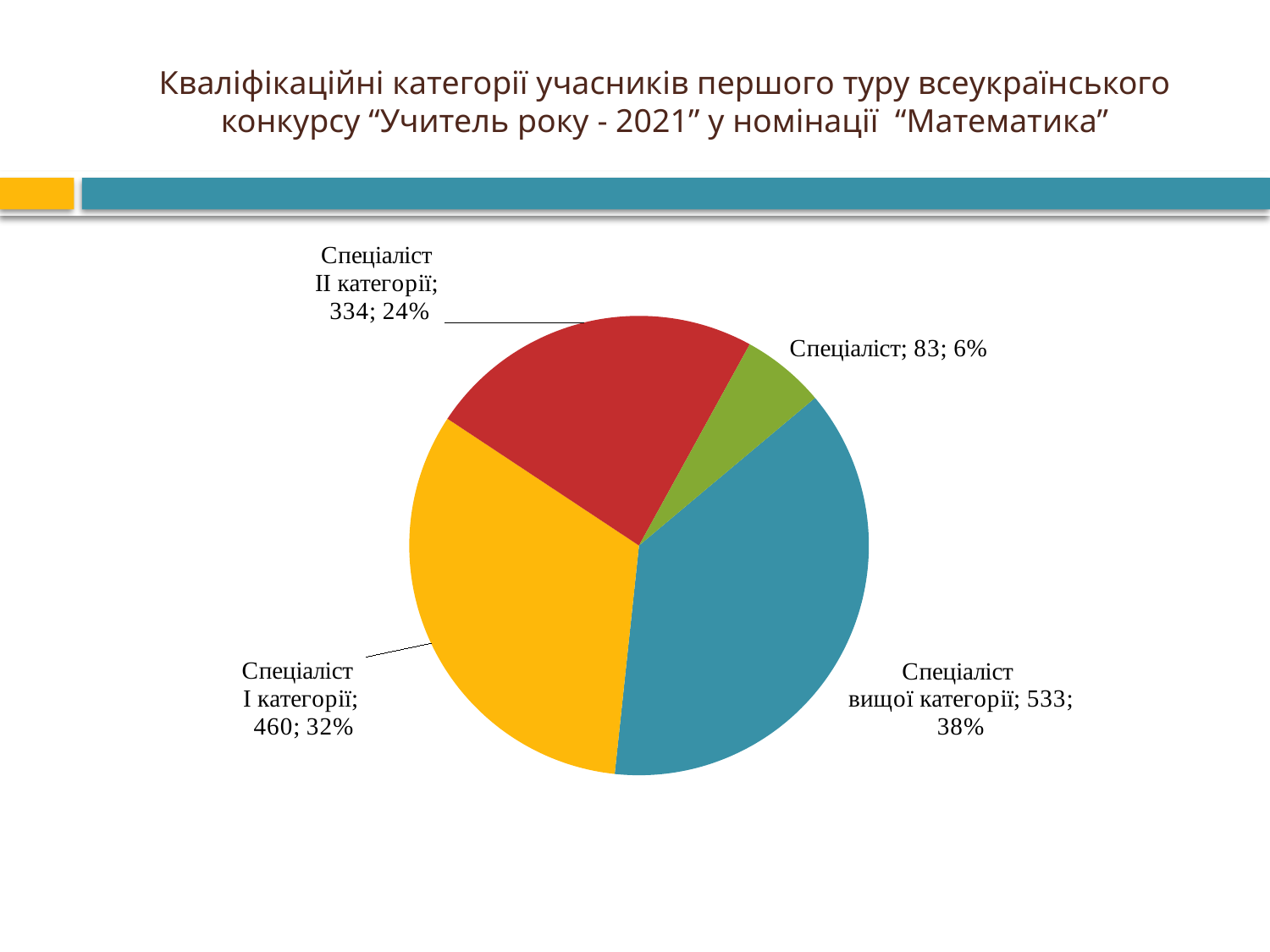
How many slices does the pie chart have? 4 Which category has the smallest slice? Спеціаліст What share of the pie does Спеціаліст I категорії represent? 32% What is the value for Спеціаліст I категорії? 460 What is the value for Спеціаліст? 83 What share of the pie does Спеціаліст II категорії represent? 24% Which is larger, the value for Спеціаліст II категорії or the value for Спеціаліст? Спеціаліст II категорії What is the value for Спеціаліст II категорії? 334 What kind of chart is shown on the slide? pie chart What is the value for Спеціаліст вищої категорії? 533 What is the difference between the values for Спеціаліст вищої категорії and Спеціаліст I категорії? 73 Which category has the largest slice? Спеціаліст вищої категорії